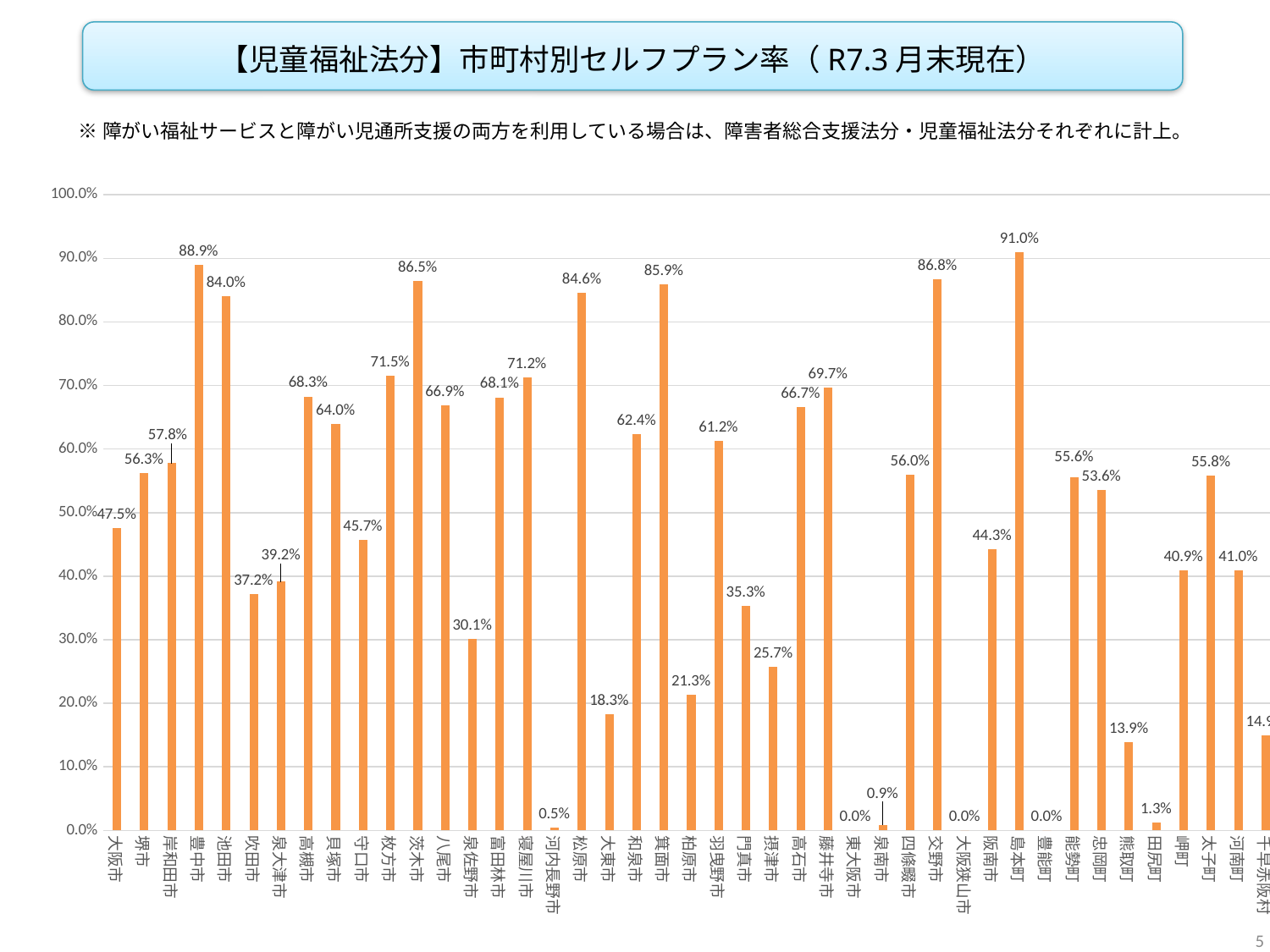
Which has a higher self-plan rate, 松原市 or 箕面市? 箕面市 What is the self-plan rate for 豊中市? 88.9% Is the value for 大阪市 greater or less than 50.0%? less What is the self-plan rate for 熊取町? 13.9% What is the difference between the self-plan rates of 豊中市 and 池田市? 4.9 percentage points What is the self-plan rate for 河内長野市? 0.5% What is the title of the chart on the slide? 【児童福祉法分】市町村別セルフプラン率（R7.3月末現在） How many municipalities are shown on the x axis? 43 Which municipality has the highest self-plan rate? 島本町 Which has a higher self-plan rate, 交野市 or 茨木市? 交野市 What is the self-plan rate for 大阪市? 47.5% What type of chart is shown on the slide? Bar chart